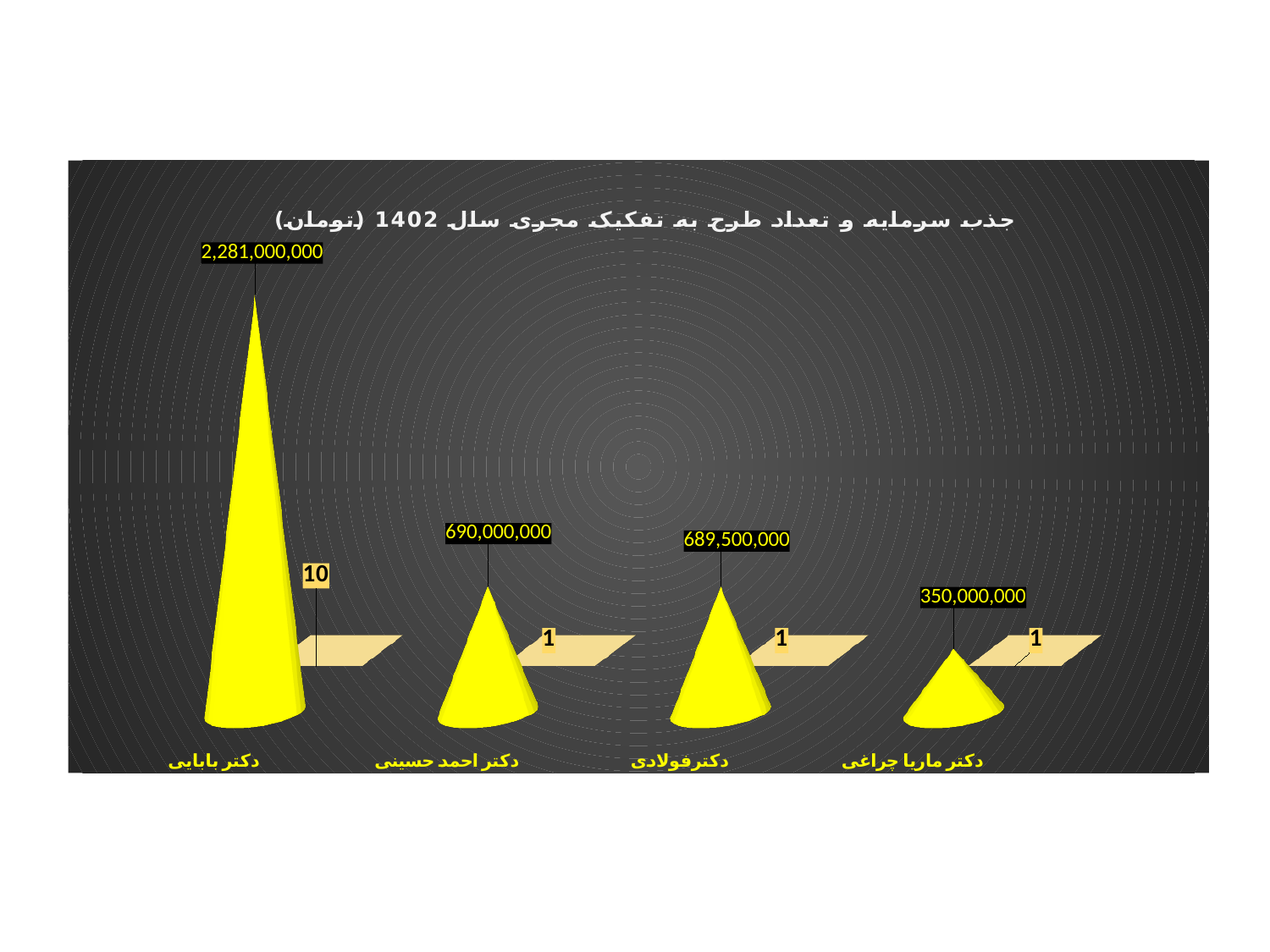
What kind of chart is shown on the slide? bar chart Which executor has the lowest capital attracted? دکتر ماریا چراغی How many projects (تعداد طرح) are shown for دکتر ماریا چراغی? 1 How many executors (categories) are shown on the chart? 4 What is the capital attracted (تومان) for دکتر بابایی? 2,281,000,000 Which executor has the highest capital attracted? دکتر بابایی What is the capital attracted (تومان) for دکتر احمد حسینی? 690,000,000 What is the capital attracted (تومان) for دکترفولادی? 689,500,000 What is the capital attracted (تومان) for دکتر ماریا چراغی? 350,000,000 How many projects (تعداد طرح) are shown for دکتر بابایی? 10 What is the difference in capital attracted between دکتر احمد حسینی and دکترفولادی? 500,000 What is the difference in capital attracted between دکتر بابایی and دکتر ماریا چراغی? 1,931,000,000